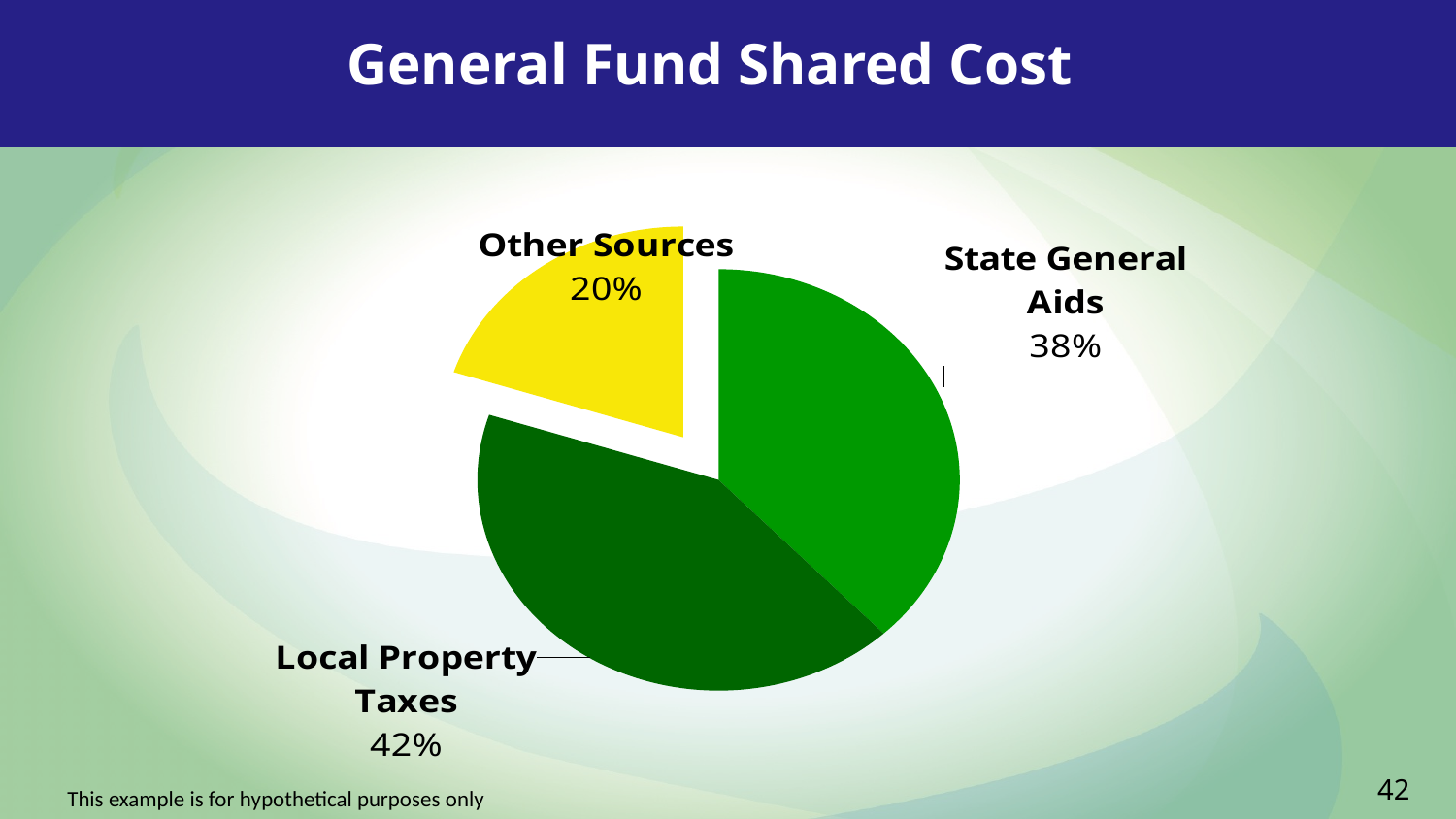
What is the difference in percentage points between Local Property Taxes and State General Aids? 4 Which is larger, State General Aids or Other Sources? State General Aids What share of the pie is Other Sources? 20% What kind of chart is shown on the slide? Pie chart Which category has the largest share of the pie? Local Property Taxes What is the title of the chart? General Fund Shared Cost What colour is the Other Sources slice? Yellow What share of the pie is State General Aids? 38% What share of the pie is Local Property Taxes? 42% Which category has the smallest share of the pie? Other Sources What is the difference in percentage points between Local Property Taxes and Other Sources? 22 How many slices does the pie chart have? 3